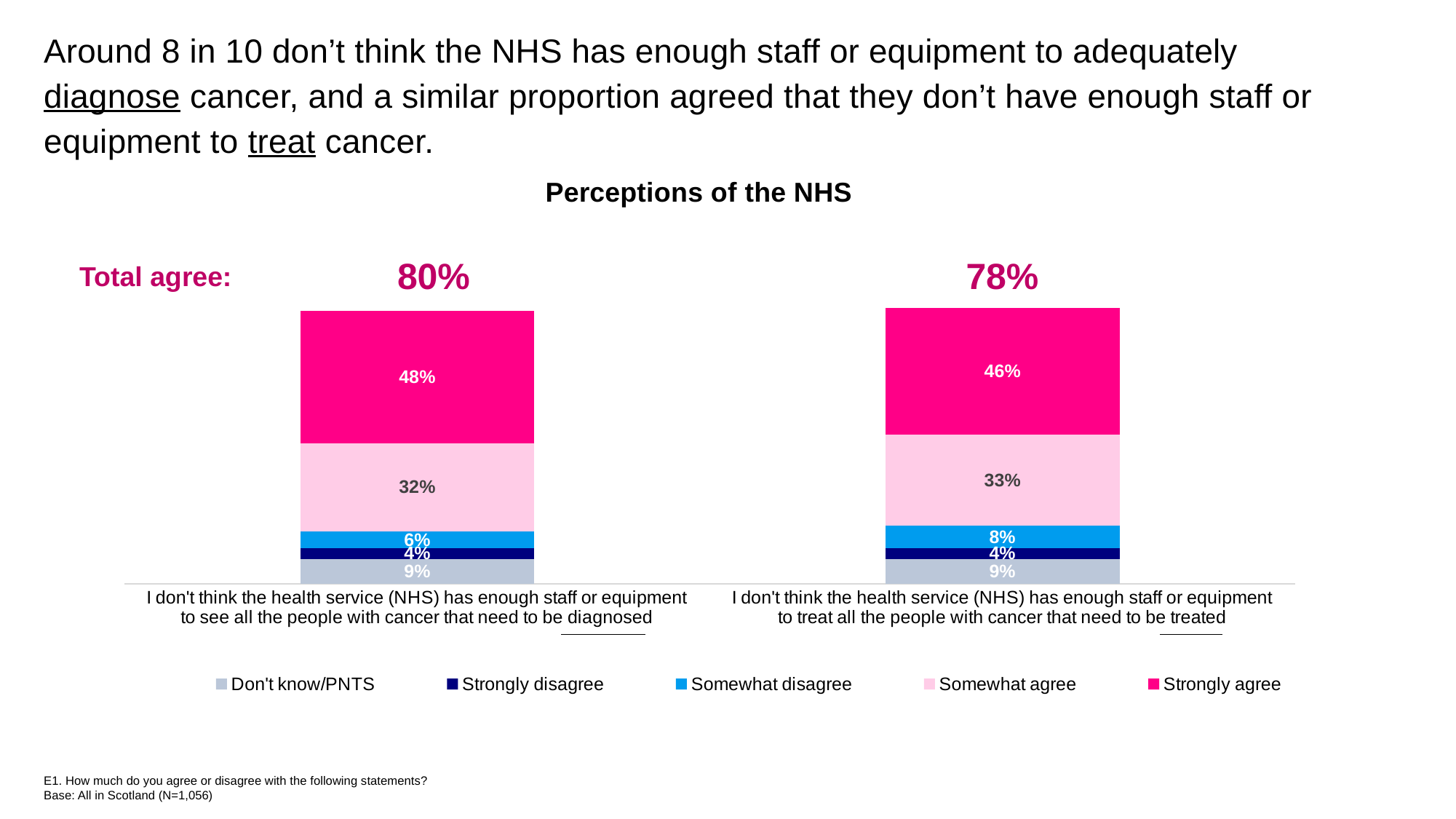
What is the difference in percentage points between the Strongly agree values for the diagnosed statement and the treated statement? 2 percentage points What percentage strongly agree that the NHS doesn't have enough staff or equipment to see all the people with cancer that need to be diagnosed? 48% How many series does the legend list? 5 Which response category is the largest segment in the bar for the statement about people with cancer that need to be diagnosed? Strongly agree What is the Don't know/PNTS value for the statement about people with cancer that need to be treated? 9% What is the title of the chart? Perceptions of the NHS How many statements (bars) are shown in the chart? 2 Which statement has the larger Somewhat disagree value, the one about being diagnosed or the one about being treated? The one about being treated What kind of chart is shown on the slide? Stacked bar chart What is the Total agree figure shown for the statement about people with cancer that need to be treated? 78% What percentage somewhat agree that the NHS doesn't have enough staff or equipment to treat all the people with cancer that need to be treated? 33% What is the Somewhat disagree value for the statement about people with cancer that need to be diagnosed? 6%